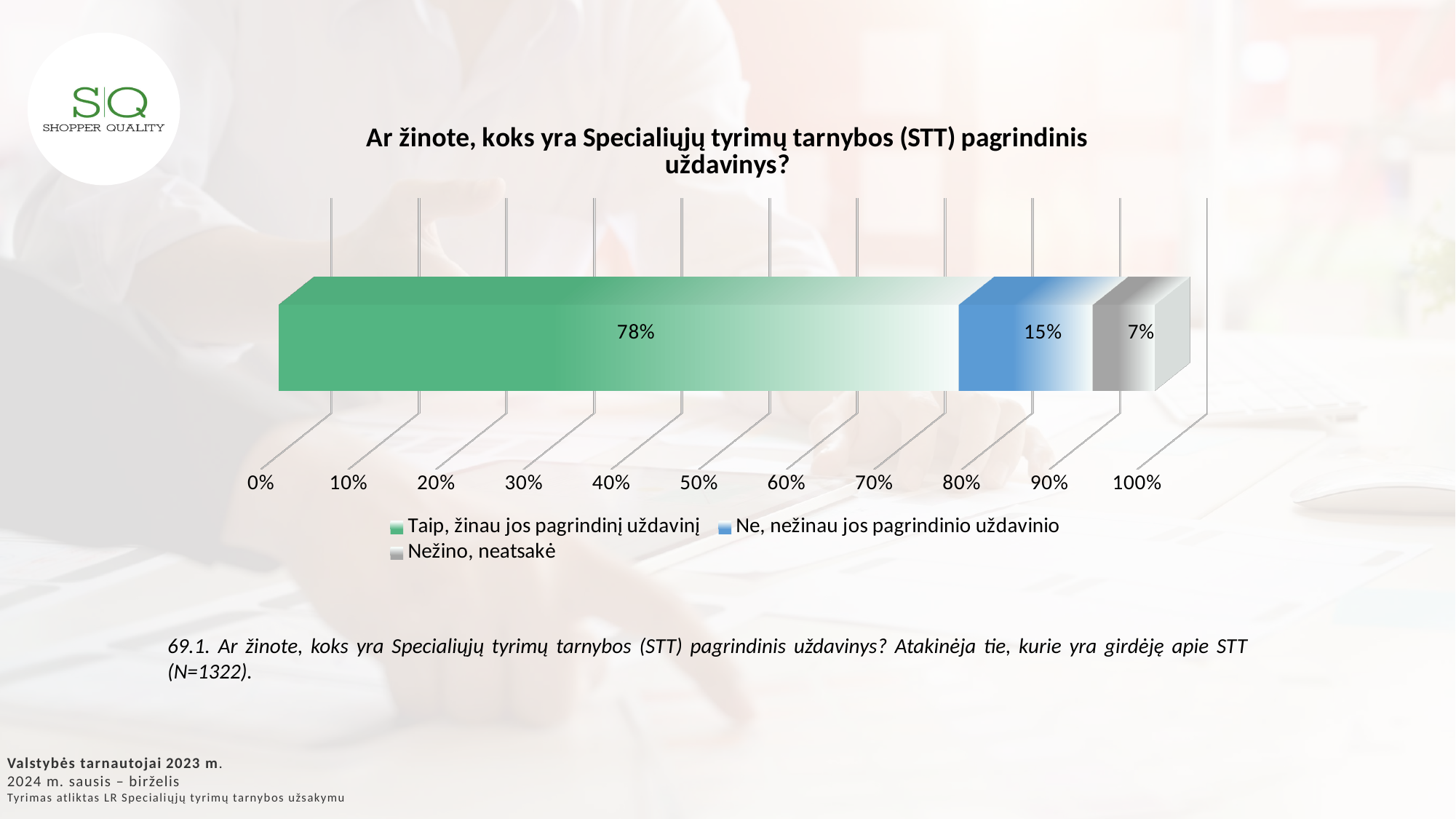
What colour is the segment for "Ne, nežinau jos pagrindinio uždavinio"? Blue What kind of chart is shown on the slide? Stacked bar chart Is the value for "Taip, žinau jos pagrindinį uždavinį" greater or less than 70%? greater How many series does the legend list? 3 Which is larger: the share for "Ne, nežinau jos pagrindinio uždavinio" or the share for "Nežino, neatsakė"? Ne, nežinau jos pagrindinio uždavinio What percentage of respondents answered "Taip, žinau jos pagrindinį uždavinį"? 78% What percentage of respondents answered "Ne, nežinau jos pagrindinio uždavinio"? 15% What is the difference between the share for "Taip, žinau jos pagrindinį uždavinį" and the share for "Ne, nežinau jos pagrindinio uždavinio"? 63% What percentage of respondents answered "Nežino, neatsakė"? 7% What is the total of the three segments in the stacked bar? 100% Which response category has the highest share? Taip, žinau jos pagrindinį uždavinį Which response category has the lowest share? Nežino, neatsakė